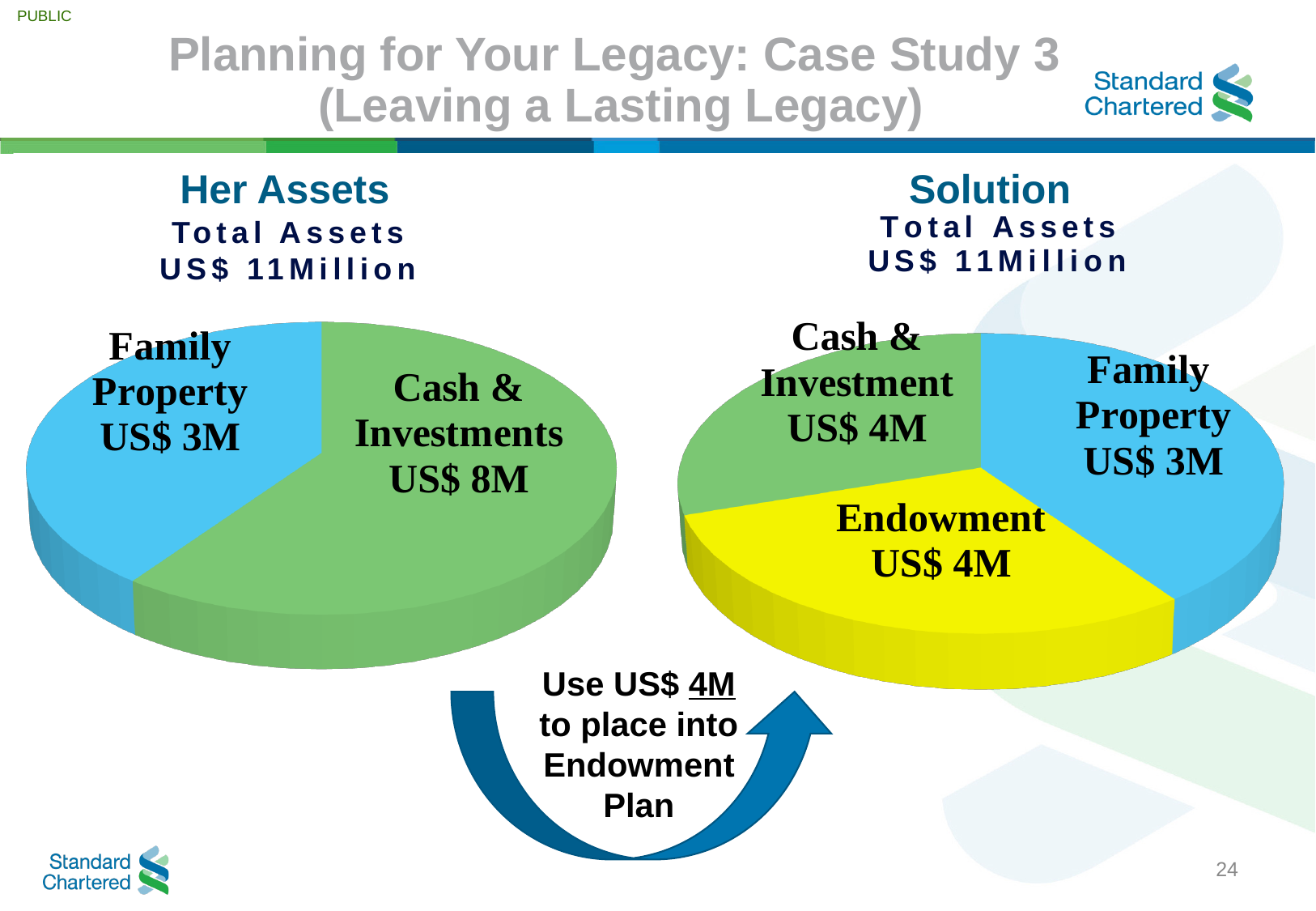
In the 'Her Assets' pie chart, what is the value for Family Property? US$ 3M In the 'Solution' pie chart, which category is the smallest? Family Property What type of chart is used for 'Her Assets'? Pie chart How many slices does the 'Solution' pie chart have? 3 In the 'Solution' pie chart, what is the value for Endowment? US$ 4M In the 'Her Assets' pie chart, which category is the largest? Cash & Investments What is the total of the assets shown in the 'Solution' pie chart? US$ 11Million In the 'Her Assets' pie chart, what is the difference between Cash & Investments and Family Property? US$ 5M In the 'Solution' pie chart, what is the value for Cash & Investment? US$ 4M How many slices does the 'Her Assets' pie chart have? 2 In the 'Her Assets' pie chart, what is the value for Cash & Investments? US$ 8M In the 'Solution' pie chart, which is larger, Endowment or Family Property? Endowment